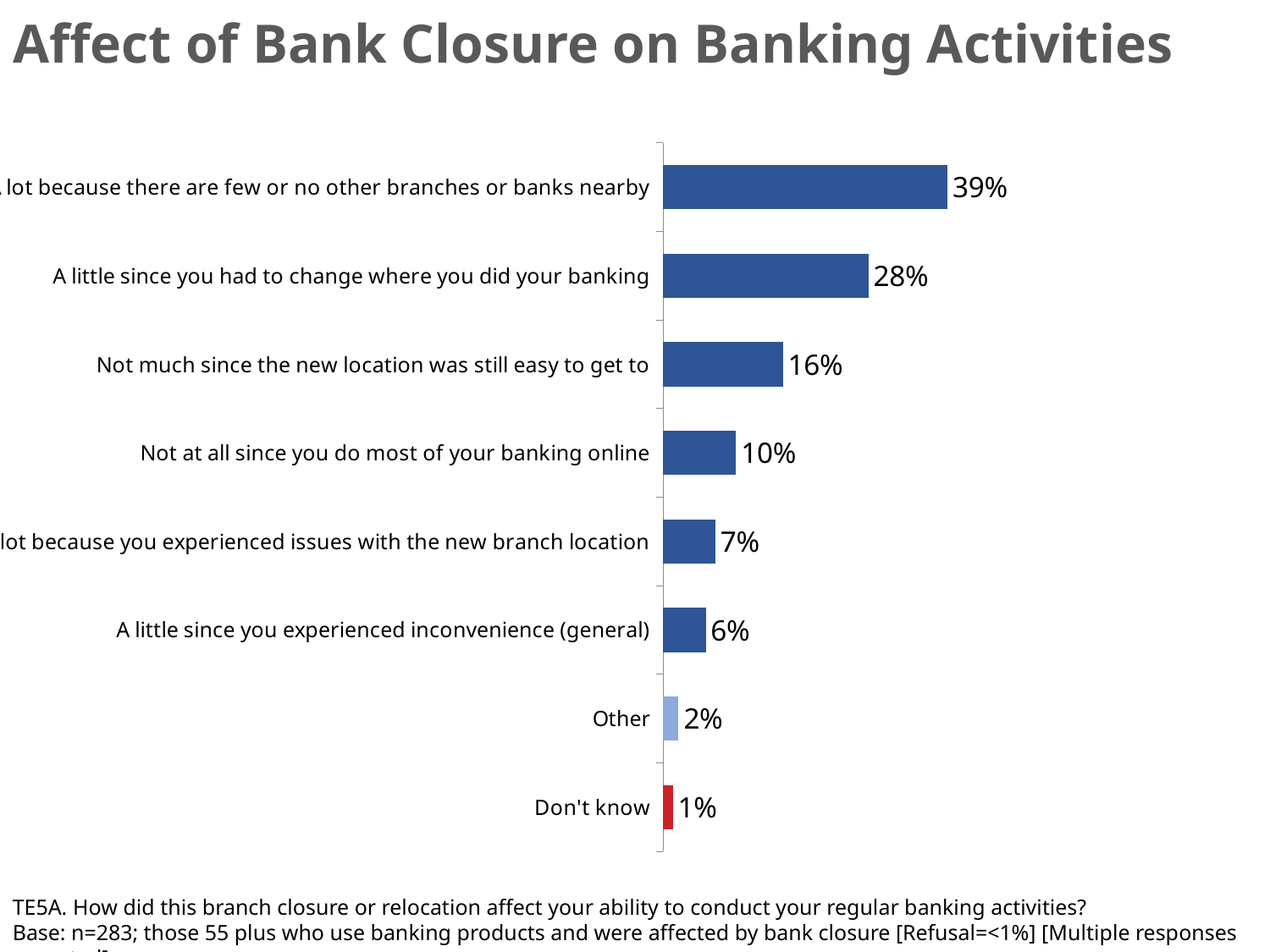
What is the title of the slide? Affect of Bank Closure on Banking Activities What is the value for "Not much since the new location was still easy to get to"? 16% Which is larger: the value for "Not at all since you do most of your banking online" or the value for the category about experiencing issues with the new branch location? Not at all since you do most of your banking online What is the difference between the value for "A little since you had to change where you did your banking" and the value for "Not much since the new location was still easy to get to"? 12% What is the value for "Other"? 2% What kind of chart is shown on the slide? Bar chart What is the value for "A little since you experienced inconvenience (general)"? 6% What is the value for "Don't know"? 1% What is the value for "Not at all since you do most of your banking online"? 10% How many categories are shown in the chart? 8 Which category has the highest value? A lot because there are few or no other branches or banks nearby Which category has the lowest value? Don't know